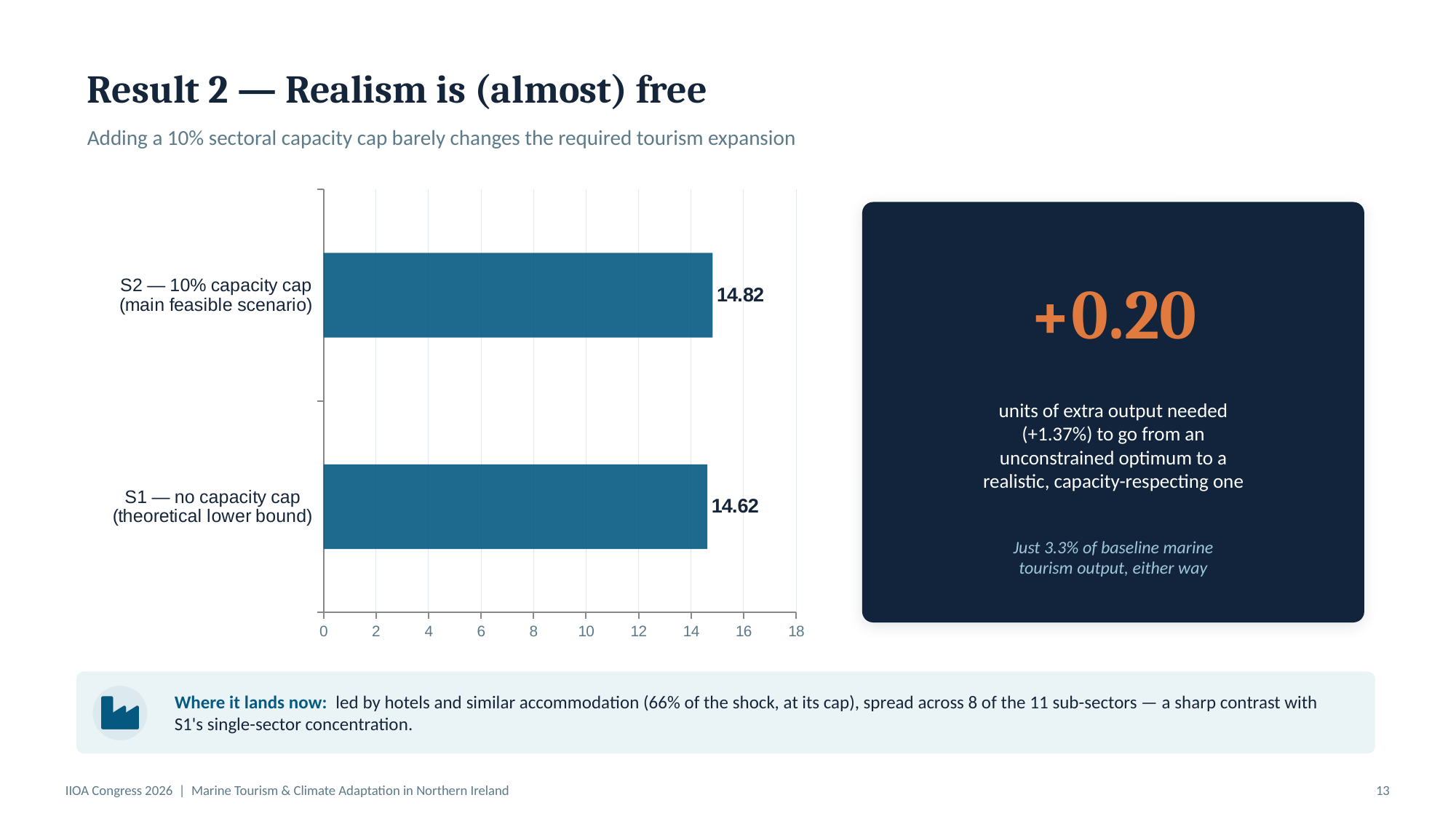
What kind of chart is shown on the slide? bar chart Which scenario has the higher value? S2 — 10% capacity cap (main feasible scenario) What is the subtitle text shown above the chart? Adding a 10% sectoral capacity cap barely changes the required tourism expansion What is the value for S1 — no capacity cap (theoretical lower bound)? 14.62 Is the value for S2 — 10% capacity cap greater or less than 14? greater Is the value for S1 — no capacity cap greater or less than 16? less How many scenarios (bars) are shown in the chart? 2 What is the maximum value shown on the x axis of the chart? 18 Which scenario has the lower value? S1 — no capacity cap (theoretical lower bound) What is the difference between the S2 and S1 values? 0.20 What is the value for S2 — 10% capacity cap (main feasible scenario)? 14.82 Is the value for S2 larger or smaller than the value for S1? larger